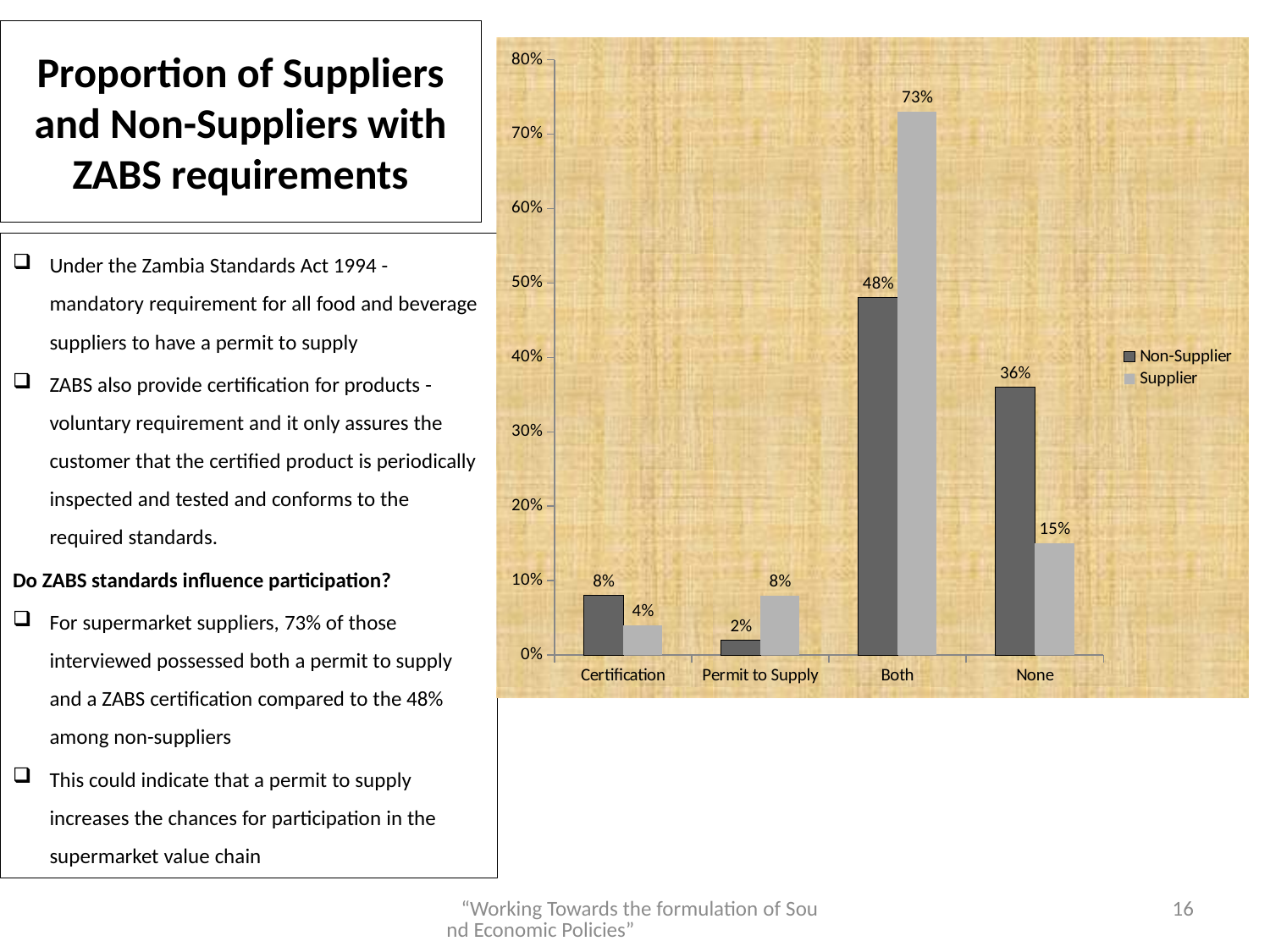
How many series does the legend list? 2 How many categories are shown on the x axis? 4 What is the Non-Supplier value for None? 36% What are the two series named in the legend? Non-Supplier and Supplier For None, which is larger: the Non-Supplier value or the Supplier value? Non-Supplier What is the Non-Supplier value for Permit to Supply? 2% What is the Supplier value for Certification? 4% What is the difference between the Supplier and Non-Supplier values for Both? 25% What kind of chart is shown on the slide? Bar chart Which category has the highest Supplier value? Both What is the Supplier value for Both? 73% Which category has the lowest Non-Supplier value? Permit to Supply